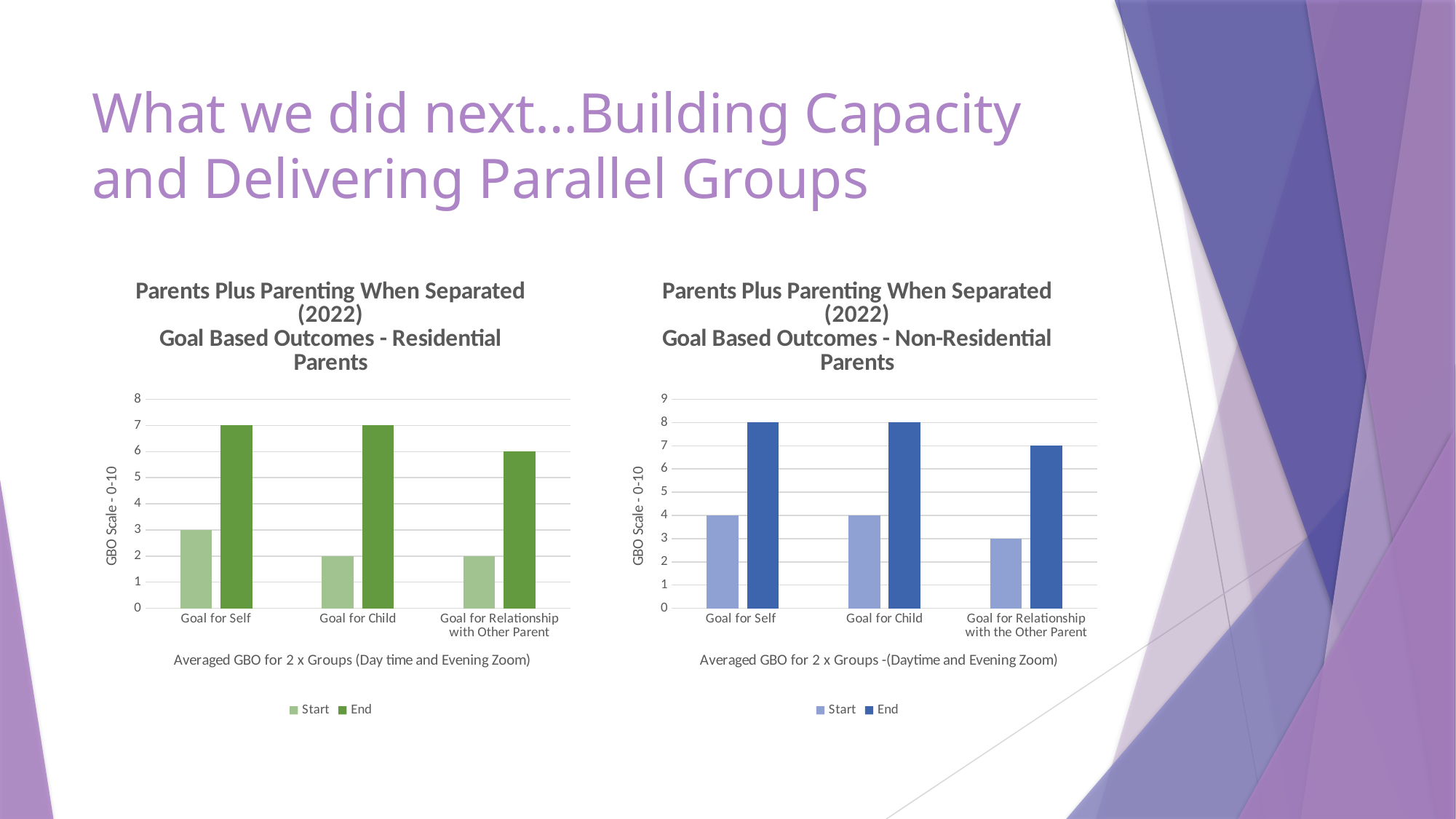
How many categories are shown on the x axis of the Residential Parents chart? 3 What type of chart is the Residential Parents chart? Bar chart In the Non-Residential Parents chart, what is the difference between the End and Start values for Goal for Self? 4 In the Residential Parents chart, what is the End value for Goal for Relationship with Other Parent? 6 In the Residential Parents chart, what is the difference between the End and Start values for Goal for Child? 5 In the Non-Residential Parents chart, which category has the lowest End value? Goal for Relationship with the Other Parent How many series does the legend of the Non-Residential Parents chart list? 2 In the Residential Parents chart, which category has the highest Start value? Goal for Self In the Non-Residential Parents chart, what is the Start value for Goal for Relationship with the Other Parent? 3 Is the End value for Goal for Self larger in the Residential Parents chart or the Non-Residential Parents chart? Non-Residential Parents chart In the Residential Parents chart, what is the Start value for Goal for Self? 3 In the Non-Residential Parents chart, what is the End value for Goal for Child? 8